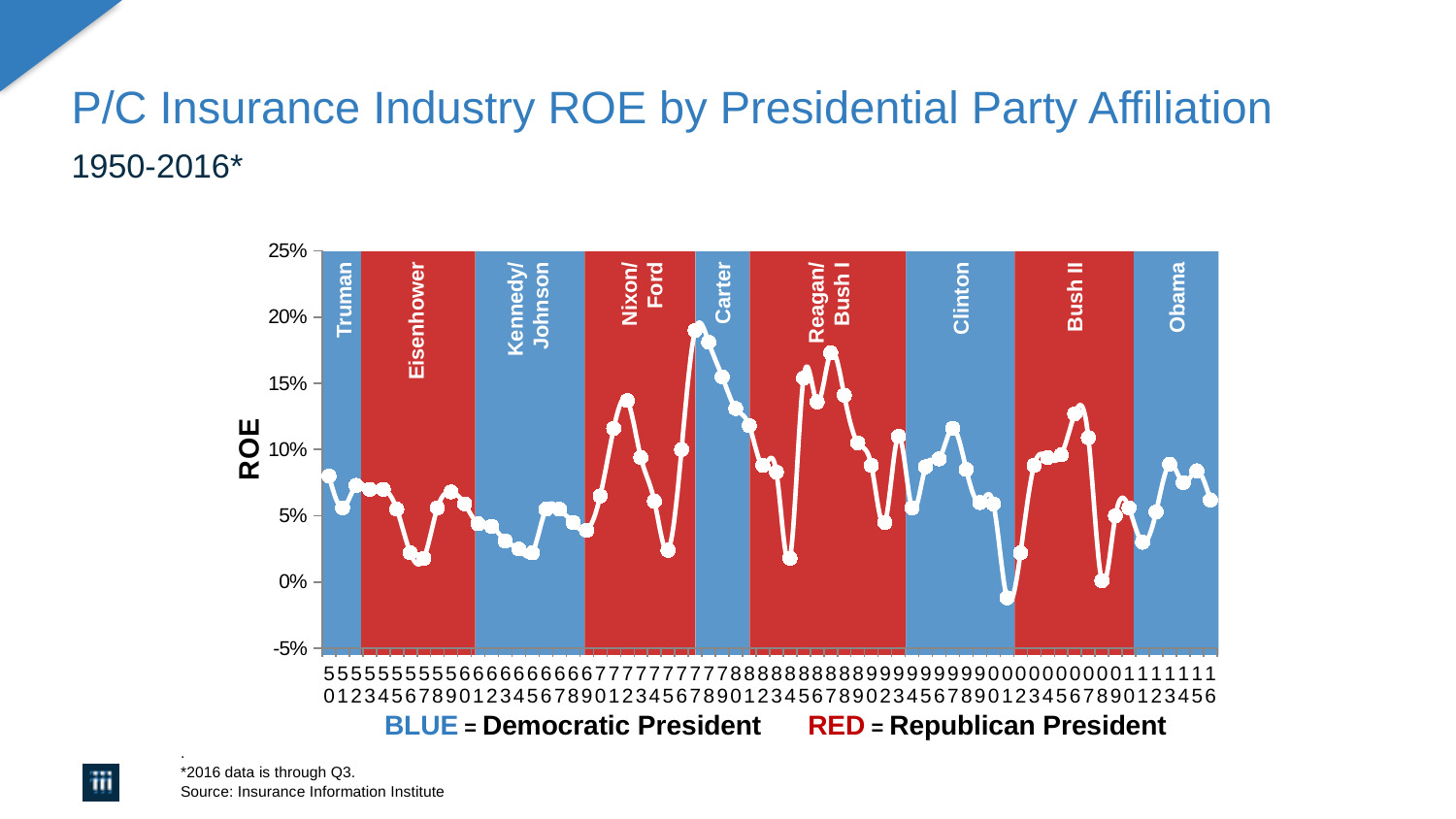
Does the ROE rise or fall from 1950 to 1957? fall How many presidential eras are labeled across the chart? 9 How many red (Republican) bands are shown on the chart? 4 Is the ROE value for 1957 greater or less than 5%? less Is the ROE value for 1984 greater or less than 5%? less What is the title of the chart? P/C Insurance Industry ROE by Presidential Party Affiliation Is the highest ROE value on the chart greater or less than 15%? greater What kind of chart is shown on the slide? Line chart According to the legend below the chart, what does a red background indicate? Republican President